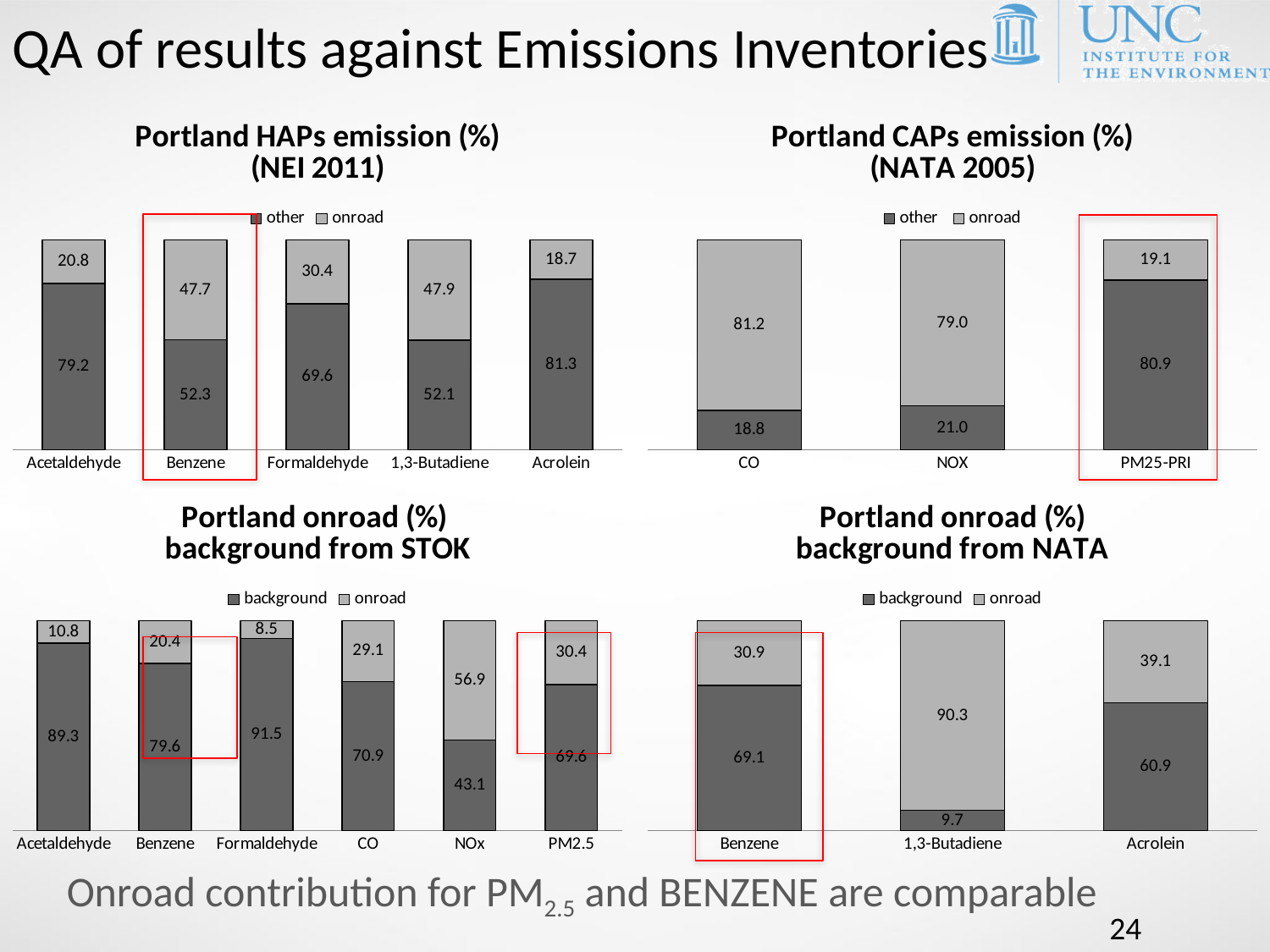
In the 'Portland HAPs emission (%) (NEI 2011)' chart, how many categories are shown on the x axis? 5 What type of chart is the 'Portland onroad (%) background from NATA' chart? Stacked bar chart In the 'Portland onroad (%) background from NATA' chart, how many series does the legend list? 2 In the 'Portland HAPs emission (%) (NEI 2011)' chart, what is the onroad value for Benzene? 47.7 In the 'Portland onroad (%) background from NATA' chart, what is the background value for 1,3-Butadiene? 9.7 In the 'Portland CAPs emission (%) (NATA 2005)' chart, what is the onroad value for CO? 81.2 In the 'Portland onroad (%) background from STOK' chart, is the onroad value larger for CO or for PM2.5? PM2.5 In the 'Portland onroad (%) background from STOK' chart, which category has the highest onroad value? NOx In the 'Portland HAPs emission (%) (NEI 2011)' chart, which category has the highest 'other' value? Acrolein In the 'Portland CAPs emission (%) (NATA 2005)' chart, which category has the lowest onroad value? PM25-PRI In the 'Portland CAPs emission (%) (NATA 2005)' chart, what is the difference between the 'other' values for NOX and CO? 2.2 In the 'Portland onroad (%) background from STOK' chart, what is the background value for Formaldehyde? 91.5